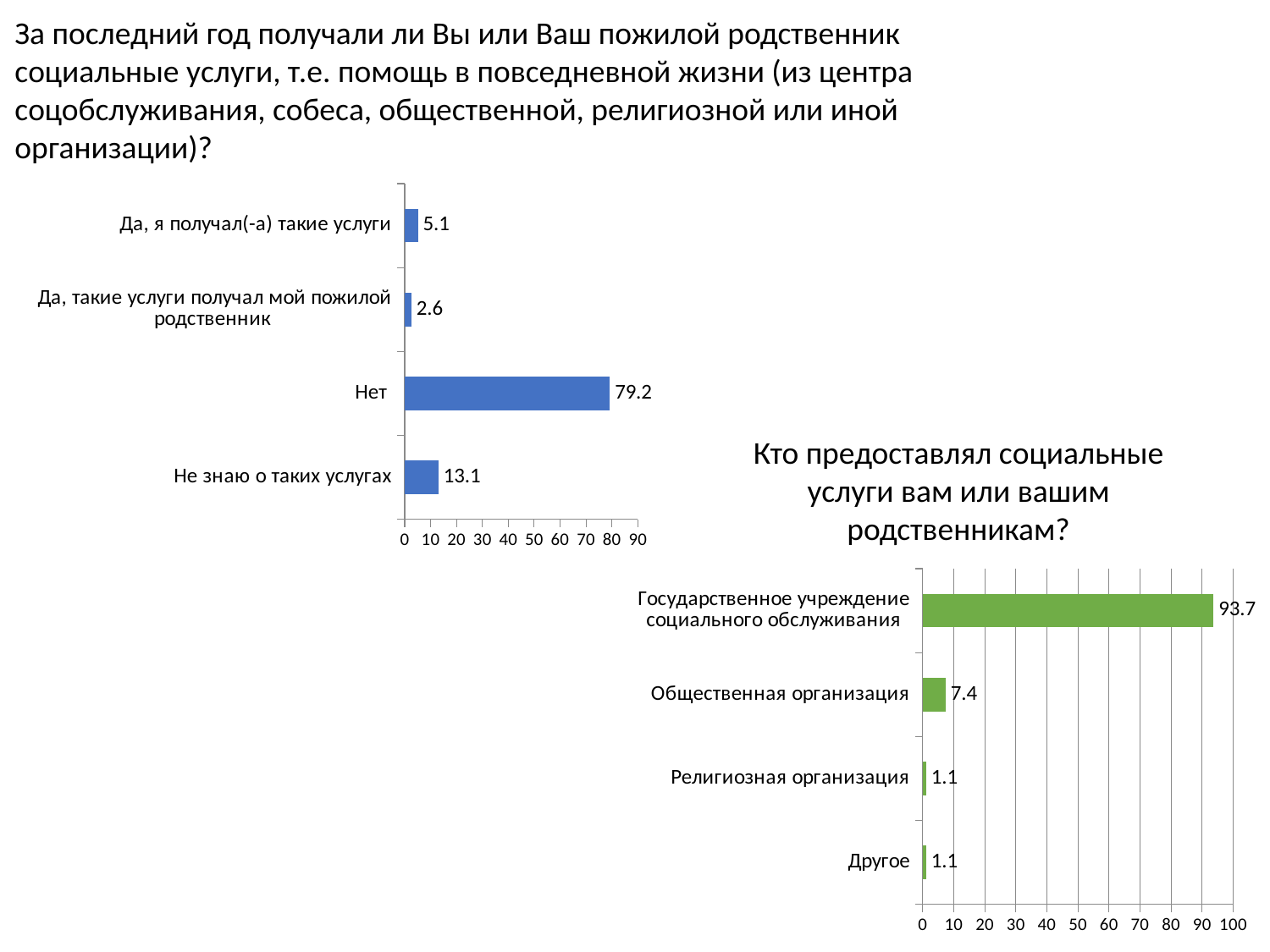
In the chart titled "Кто предоставлял социальные услуги вам или вашим родственникам?", what is the value for "Общественная организация"? 7.4 In the left chart about receiving social services in the last year, what is the value for "Не знаю о таких услугах"? 13.1 What colour are the bars in the chart titled "Кто предоставлял социальные услуги вам или вашим родственникам?"? Green In the left chart about receiving social services in the last year, what is the difference between "Нет" and "Не знаю о таких услугах"? 66.1 In the left chart about receiving social services in the last year, which category has the lowest value? Да, такие услуги получал мой пожилой родственник In the chart titled "Кто предоставлял социальные услуги вам или вашим родственникам?", what is the difference between "Государственное учреждение социального обслуживания" and "Общественная организация"? 86.3 What type of chart is the one titled "Кто предоставлял социальные услуги вам или вашим родственникам?"? Bar chart In the left chart about receiving social services in the last year, how many categories are shown? 4 In the chart titled "Кто предоставлял социальные услуги вам или вашим родственникам?", what is the value for "Государственное учреждение социального обслуживания"? 93.7 In the left chart about receiving social services in the last year, which is larger: "Да, я получал(-а) такие услуги" or "Да, такие услуги получал мой пожилой родственник"? Да, я получал(-а) такие услуги In the left chart about receiving social services in the last year, what is the value for "Нет"? 79.2 In the chart titled "Кто предоставлял социальные услуги вам или вашим родственникам?", which category has the highest value? Государственное учреждение социального обслуживания